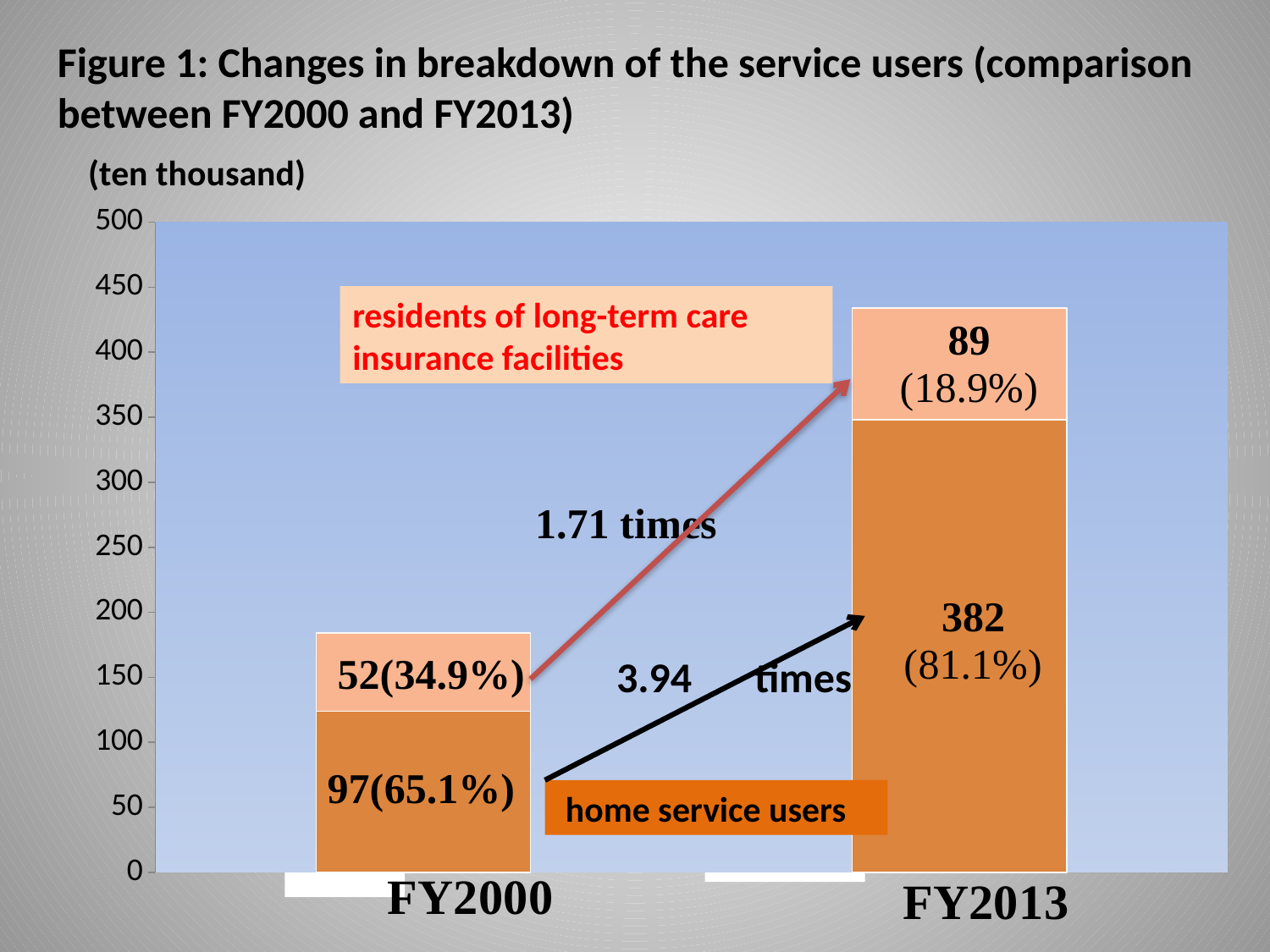
What is the total of the stacked bar for FY2000? 149 By how many times did the number of home service users increase from FY2000 to FY2013, according to the label on the chart? 3.94 times What type of chart is shown on the slide? stacked bar chart What is the difference between the home service users values in FY2013 and FY2000? 285 What is the value for residents of long-term care insurance facilities in FY2013? 89 Is the total height of the FY2013 bar greater or less than 400? greater What percentage share do residents of long-term care insurance facilities make up in FY2000? 34.9% Which is larger in FY2013: home service users or residents of long-term care insurance facilities? home service users What percentage share do home service users make up in FY2013? 81.1% What is the total of the stacked bar for FY2013? 471 What is the value for home service users in FY2000? 97 How many fiscal years (categories) are shown on the x axis? 2